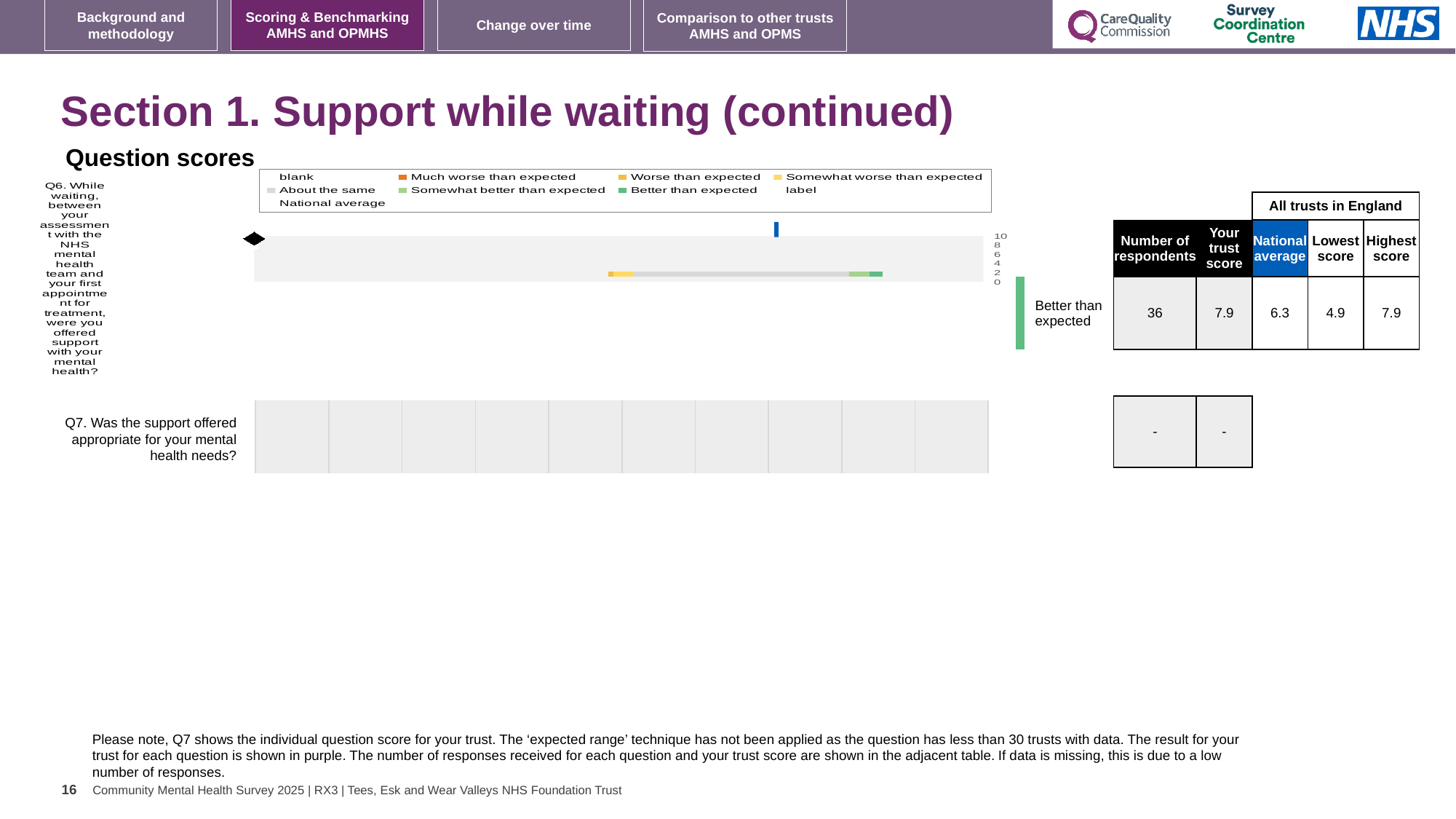
How many respondents answered Q6? 36 What is the highest value shown on the chart's score axis for Q6? 10 What category label is given to the trust's Q6 result next to the chart? Better than expected For Q6, what is the difference between the trust's score and the national average? 1.6 What is the highest score among all trusts in England for Q6? 7.9 What is the trust's score for Q6? 7.9 Which legend entry is shown in dark green on the Q6 chart? Better than expected What kind of chart is used to show the Q6 question score? bar chart What is the lowest score among all trusts in England for Q6? 4.9 What is the national average score for Q6? 6.3 Is the trust's Q6 score greater or less than 6 on the chart's axis? greater For Q6, which is larger: the trust's score or the national average? the trust's score